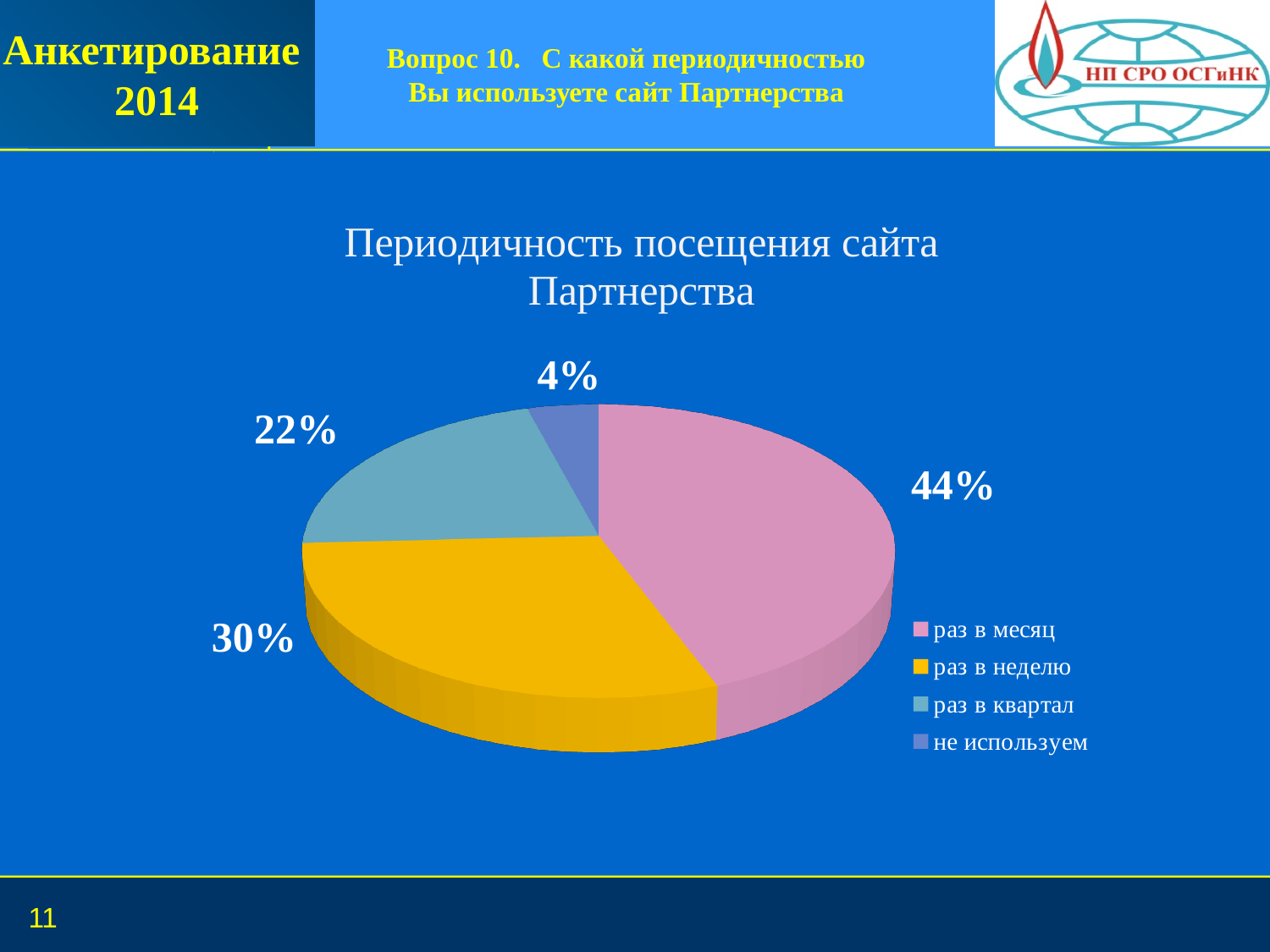
Which category has the largest slice? раз в месяц What is the difference in percentage points between 'раз в месяц' and 'раз в неделю'? 14 What share of the pie is 'не используем'? 4% What kind of chart is shown on the slide? pie chart What share of the pie is 'раз в месяц'? 44% Which is larger, 'раз в квартал' or 'раз в неделю'? раз в неделю What is the title of the chart? Периодичность посещения сайта Партнерства What share of the pie is 'раз в квартал'? 22% Which category has the smallest slice? не используем How many categories does the pie chart have? 4 What colour is the slice for 'раз в неделю'? yellow